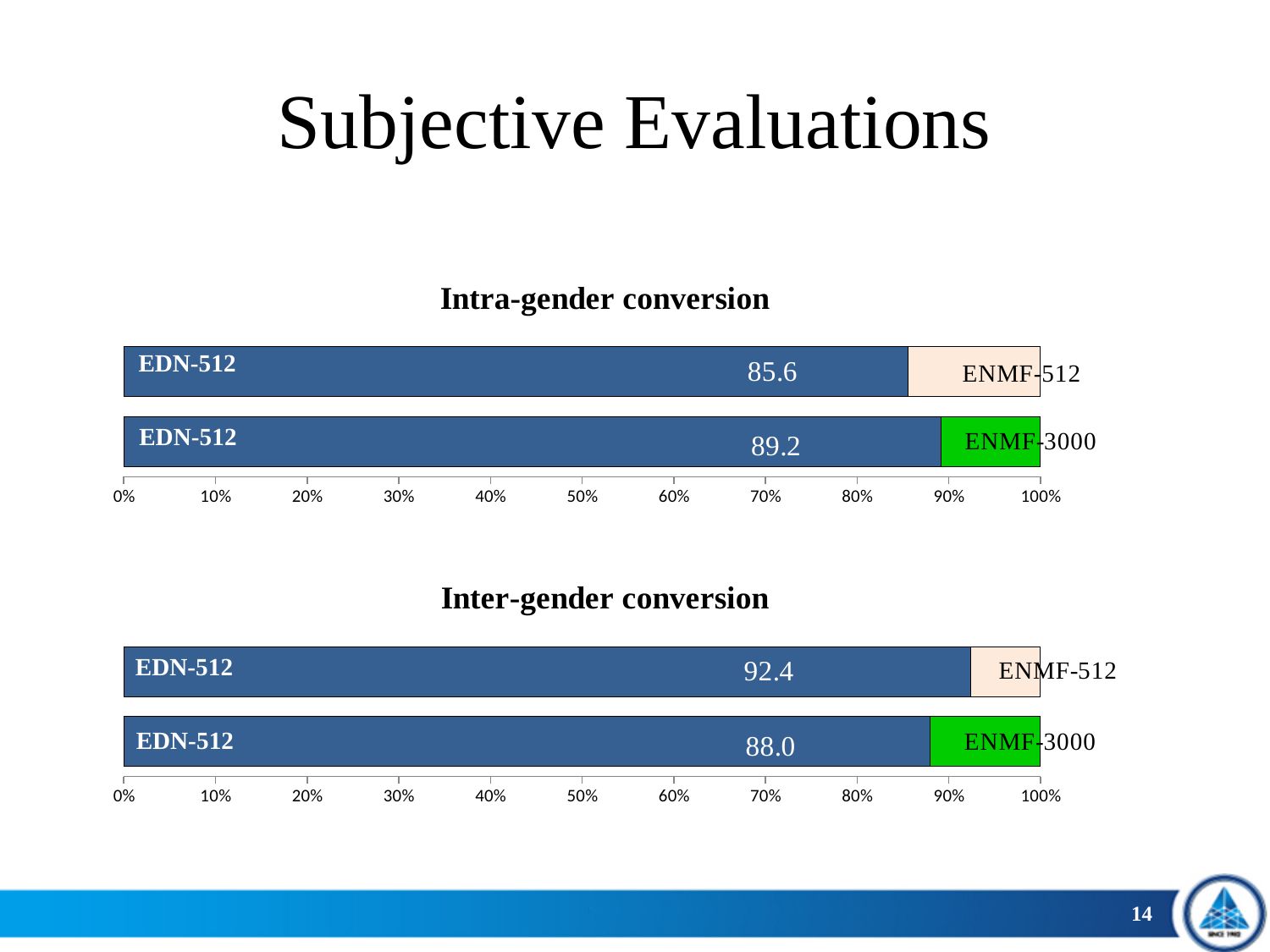
In the Inter-gender conversion chart, what is the difference between the two printed EDN-512 values? 4.4 In the Intra-gender conversion chart, is the EDN-512 value in the bar against ENMF-512 greater or less than 90%? less In the Inter-gender conversion chart, is the EDN-512 value larger when compared against ENMF-512 or against ENMF-3000? ENMF-512 In the Intra-gender conversion chart, what value is printed on the EDN-512 segment of the bar compared against ENMF-512? 85.6 In the Intra-gender conversion chart, what is the difference between the two printed EDN-512 values? 3.6 In the Inter-gender conversion chart, what value is printed on the EDN-512 segment of the bar compared against ENMF-512? 92.4 What kind of chart is the Intra-gender conversion chart? Stacked bar chart In the Inter-gender conversion chart, what value is printed on the EDN-512 segment of the bar compared against ENMF-3000? 88.0 In the Inter-gender conversion chart, is the EDN-512 value in the bar against ENMF-512 greater or less than 90%? greater In the Intra-gender conversion chart, is the EDN-512 value larger when compared against ENMF-512 or against ENMF-3000? ENMF-3000 In the Intra-gender conversion chart, what value is printed on the EDN-512 segment of the bar compared against ENMF-3000? 89.2 How many bars does the Inter-gender conversion chart contain? 2